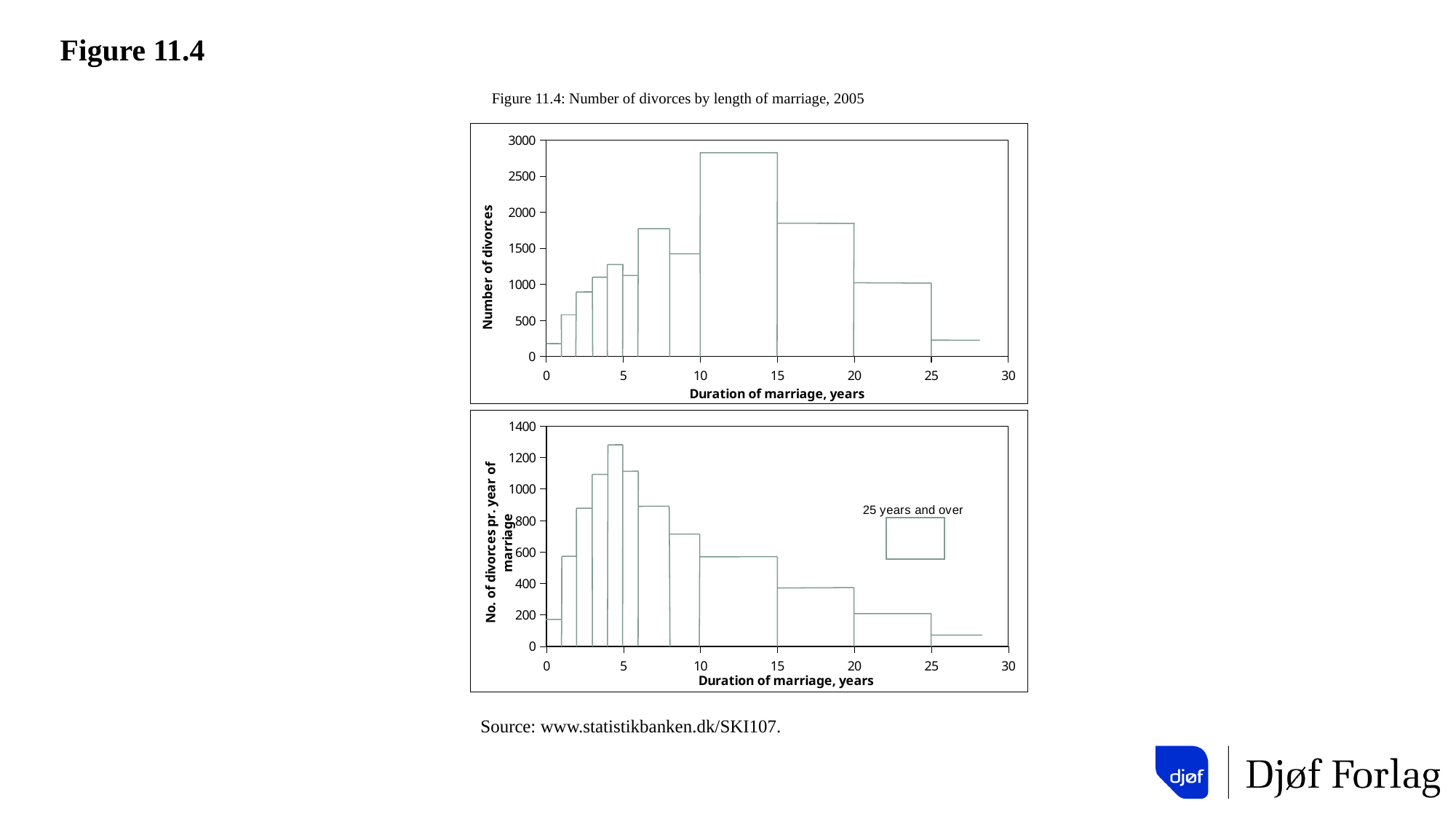
What does the label next to the small box in the bottom chart say? 25 years and over In the bottom chart (No. of divorces pr. year of marriage), which duration interval has the highest value? 4 to 5 years In the bottom chart (No. of divorces pr. year of marriage), do the values rise or fall as the duration of marriage increases from 10 years to 25 years? fall What is the x-axis label of the top chart? Duration of marriage, years In the top chart (Number of divorces), is the value for the 10 to 15 years interval greater or less than 2500? greater In the top chart (Number of divorces), is the value for the 0 to 1 year interval greater or less than 500? less In the bottom chart (No. of divorces pr. year of marriage), is the value for the 20 to 25 years interval greater or less than 400? less What kind of chart is the top chart on the slide? bar chart In the top chart (Number of divorces), which is larger: the value for 6 to 8 years or the value for 8 to 10 years? 6 to 8 years In the top chart (Number of divorces), which duration-of-marriage interval has the highest number of divorces? 10 to 15 years